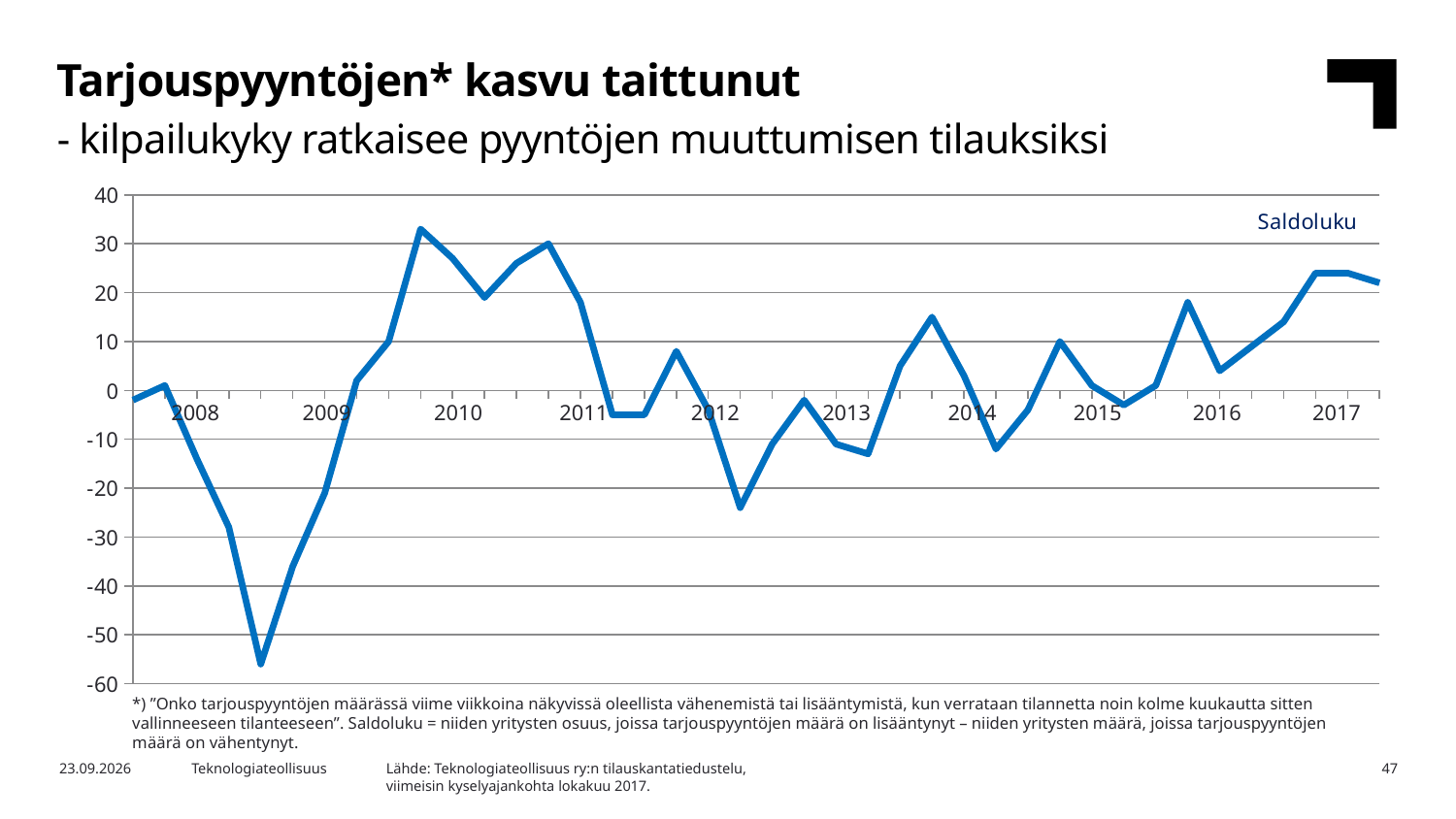
What is the highest value shown on the y axis of the chart? 40 Does the line rise or fall between the 2016 label and the 2017 label? rise Is the last plotted value in 2017 greater or less than 10? greater What kind of chart is shown on the slide? line chart Is the lowest point of the line greater or less than -50? less Is the value at the start of 2008 greater or less than 10? less What is the name of the series shown in the chart legend? Saldoluku Is the lowest point of the line located before or after the 2010 label on the x axis? before Does the line rise or fall from the 2008 label to its lowest point? fall How many series does the chart's legend list? 1 How many years are labelled on the x axis of the chart? 10